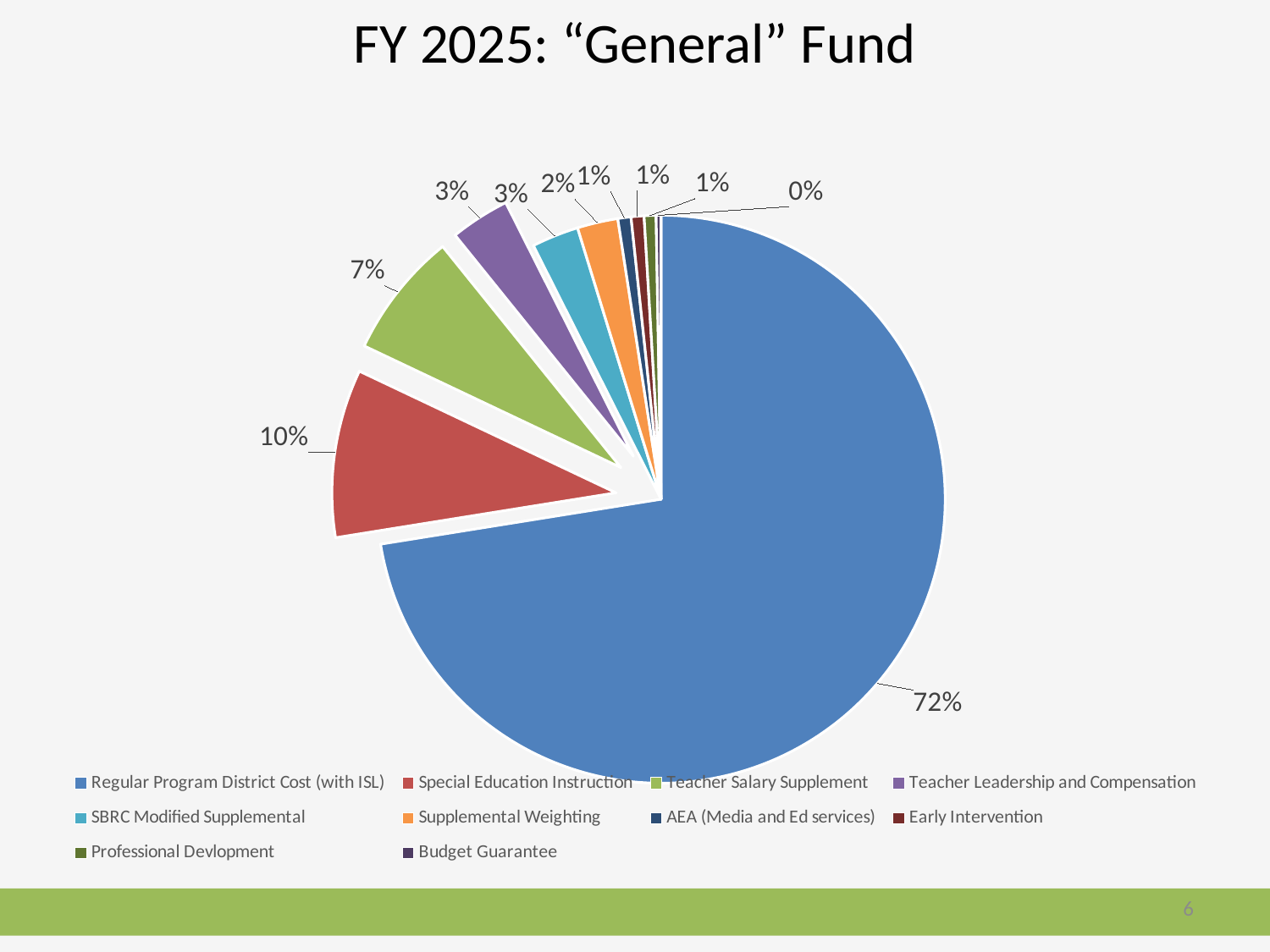
What percentage does the Special Education Instruction slice show? 10% What is the title of the slide? FY 2025: "General" Fund Which is larger, the Special Education Instruction slice or the Teacher Salary Supplement slice? Special Education Instruction How many categories does the legend list? 10 What percentage is shown for Supplemental Weighting? 2% What percentage is labelled for Teacher Salary Supplement? 7% What kind of chart is shown on the slide? Pie chart By how many percentage points does Regular Program District Cost (with ISL) exceed Special Education Instruction? 62 percentage points Which category has the smallest slice, labelled 0%? Budget Guarantee What share of the FY 2025 "General" Fund pie is Regular Program District Cost (with ISL)? 72% Which category has the largest slice of the pie? Regular Program District Cost (with ISL) What colour is the Regular Program District Cost (with ISL) slice? Blue